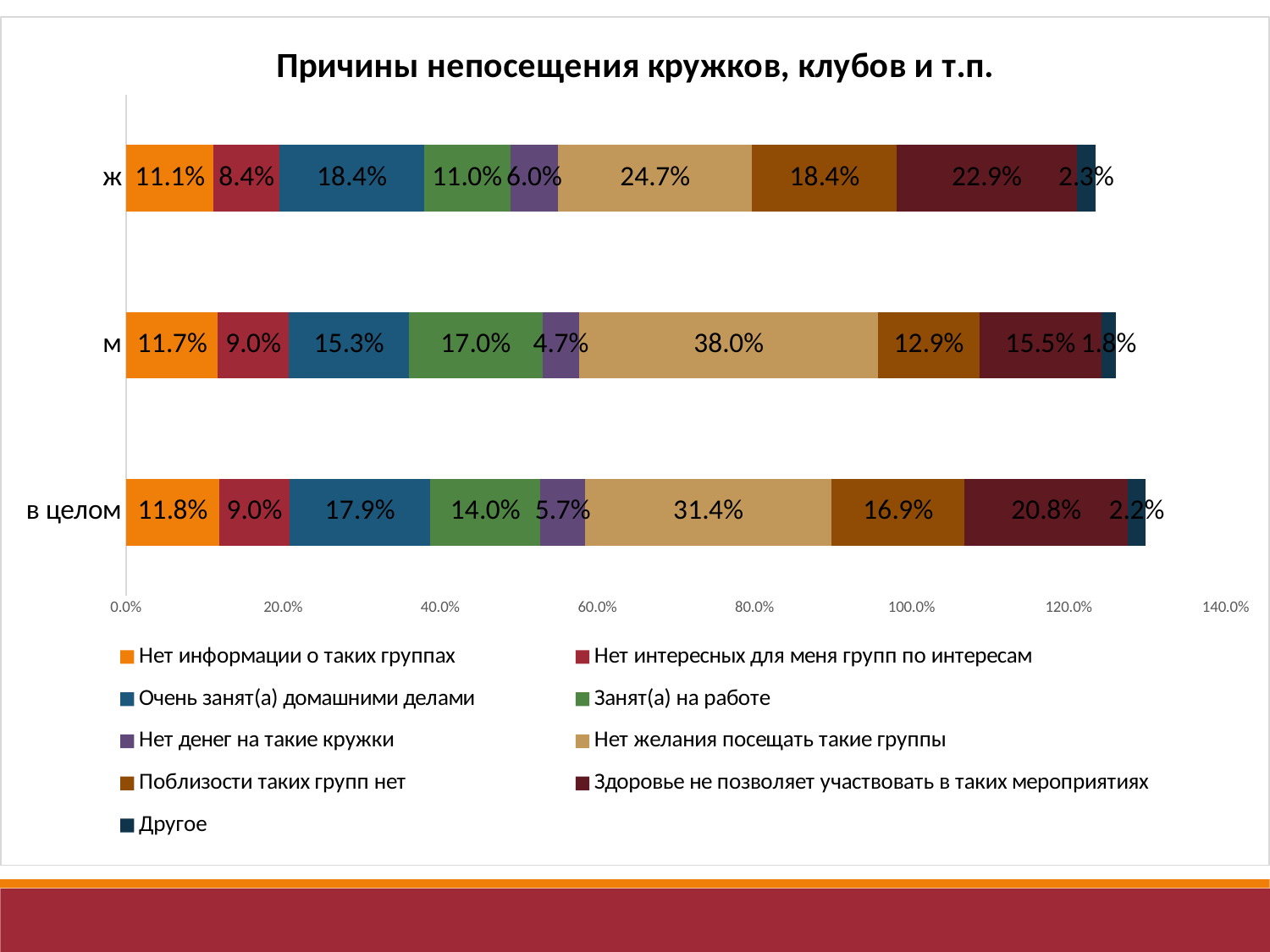
What is the value of 'Нет желания посещать такие группы' for the 'м' category? 38.0% What is the value of 'Нет информации о таких группах' for 'в целом'? 11.8% What is the value of 'Здоровье не позволяет участвовать в таких мероприятиях' for the 'ж' category? 22.9% Which is larger: 'Занят(а) на работе' for 'м' or for 'ж'? м How many series does the legend list? 9 How many categories are shown on the vertical axis? 3 What is the title of the chart? Причины непосещения кружков, клубов и т.п. What type of chart is shown on the slide? Stacked bar chart What is the value of 'Другое' for the 'м' category? 1.8% What is the difference between the 'Нет желания посещать такие группы' values for 'м' and 'ж'? 13.3% Which category has the highest value for 'Нет желания посещать такие группы'? м Which category has the lowest value for 'Нет денег на такие кружки'? м